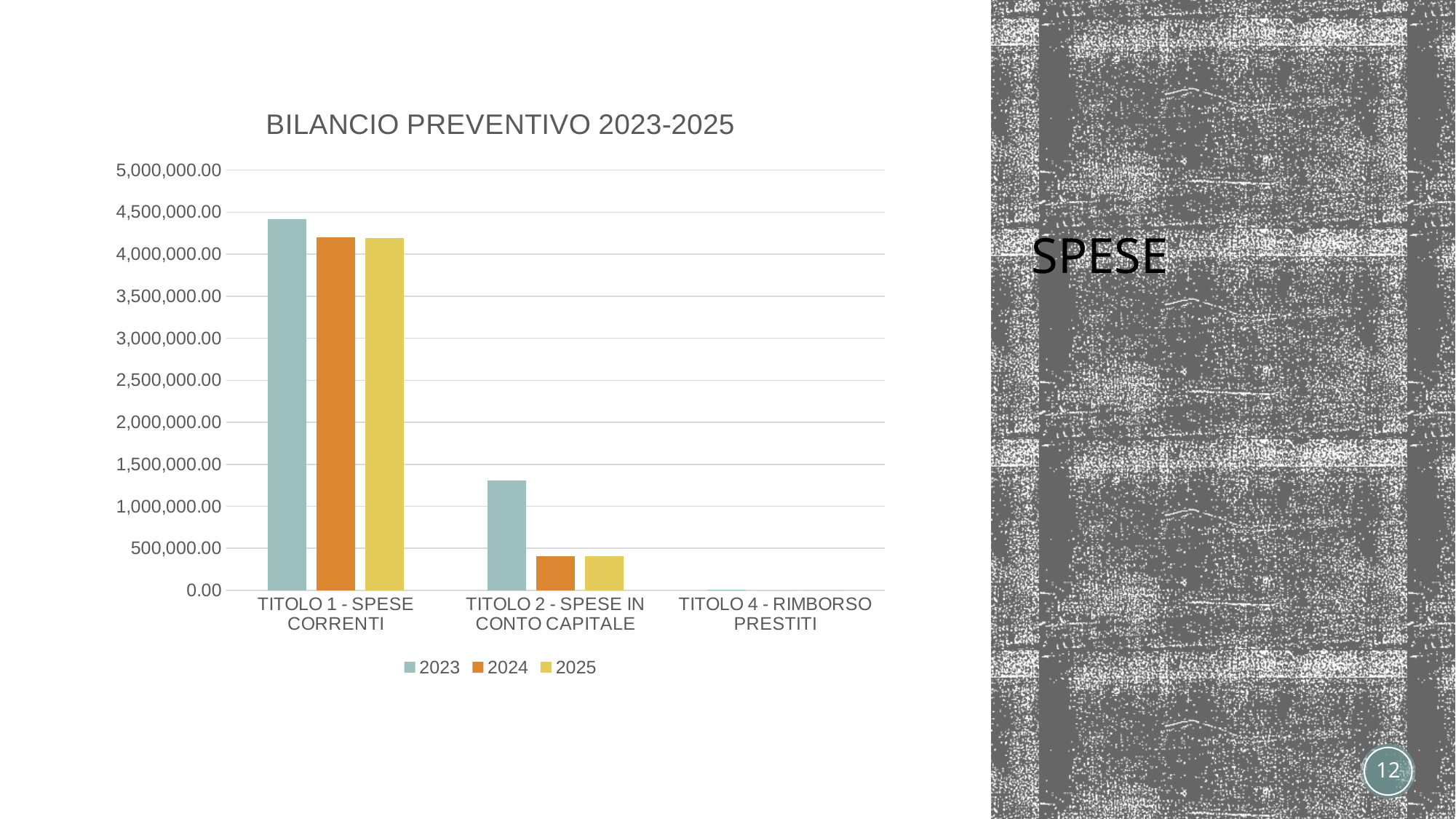
Which category has the lowest value for 2023? TITOLO 4 - RIMBORSO PRESTITI For TITOLO 2 - SPESE IN CONTO CAPITALE, which year has the larger value, 2023 or 2025? 2023 Is the 2025 value for TITOLO 1 - SPESE CORRENTI greater or less than 4,500,000.00? less How many categories are shown on the x axis? 3 What kind of chart is shown on the slide? bar chart For TITOLO 1 - SPESE CORRENTI, which year has the larger value, 2023 or 2024? 2023 How many series does the legend list? 3 What is the title of the chart? BILANCIO PREVENTIVO 2023-2025 Is the 2024 value for TITOLO 2 - SPESE IN CONTO CAPITALE greater or less than 500,000.00? less Is the 2023 value for TITOLO 1 - SPESE CORRENTI greater or less than 4,000,000.00? greater Which category has the highest value for 2023? TITOLO 1 - SPESE CORRENTI